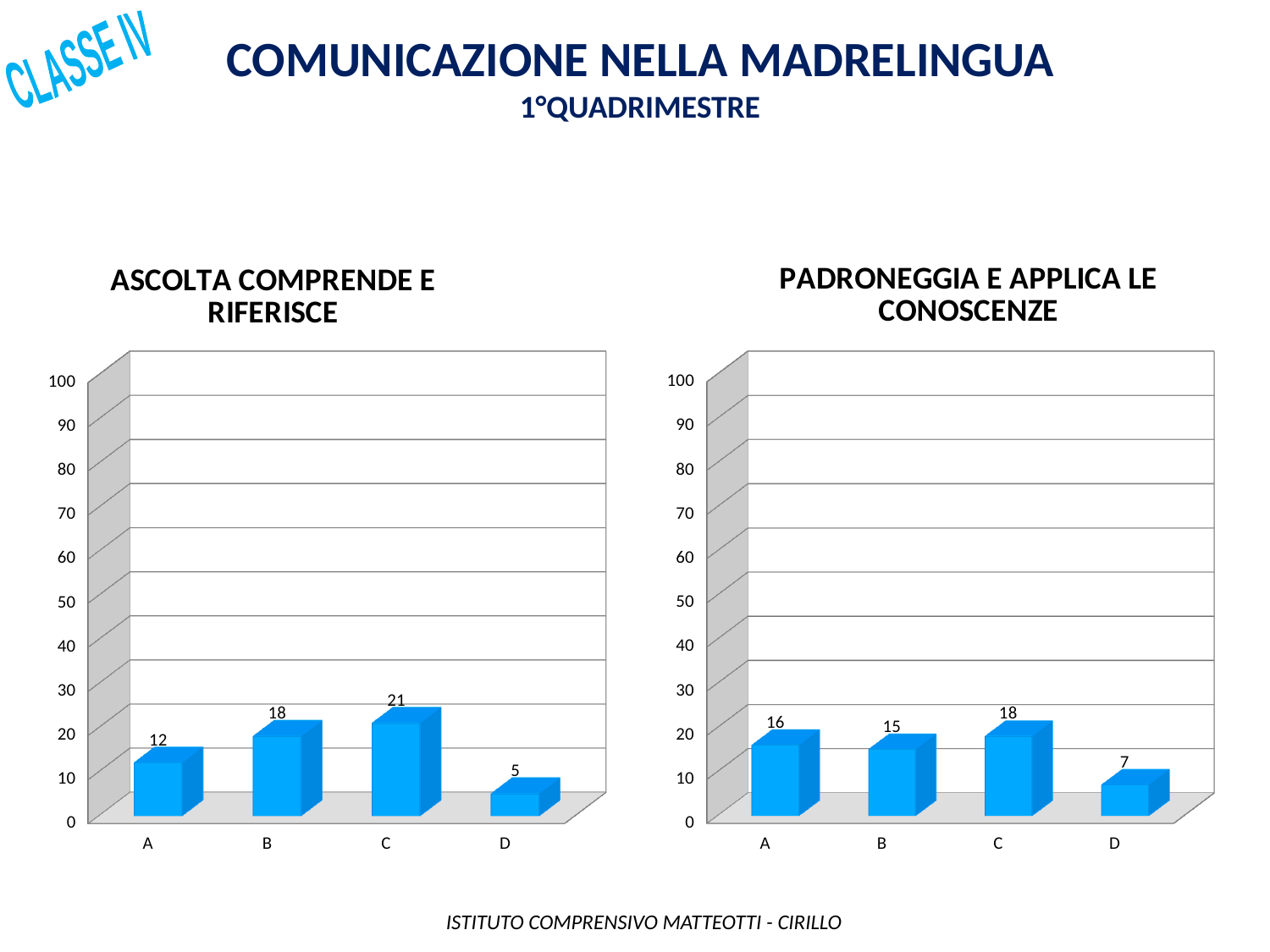
In the 'PADRONEGGIA E APPLICA LE CONOSCENZE' chart, is the value for C greater or less than 10? greater In the 'ASCOLTA COMPRENDE E RIFERISCE' chart, which category has the highest value? C In the 'ASCOLTA COMPRENDE E RIFERISCE' chart, what is the value for category C? 21 In the 'PADRONEGGIA E APPLICA LE CONOSCENZE' chart, what is the value for category B? 15 In the 'PADRONEGGIA E APPLICA LE CONOSCENZE' chart, which category has the lowest value? D What kind of chart is the 'PADRONEGGIA E APPLICA LE CONOSCENZE' chart? bar chart In the 'PADRONEGGIA E APPLICA LE CONOSCENZE' chart, what is the difference between the values for C and D? 11 How many categories are shown in the 'ASCOLTA COMPRENDE E RIFERISCE' chart? 4 In the 'ASCOLTA COMPRENDE E RIFERISCE' chart, what is the difference between the values for B and A? 6 In the 'ASCOLTA COMPRENDE E RIFERISCE' chart, which is larger, the value for A or the value for B? B In the 'ASCOLTA COMPRENDE E RIFERISCE' chart, what is the value for category D? 5 In the 'PADRONEGGIA E APPLICA LE CONOSCENZE' chart, what is the value for category A? 16